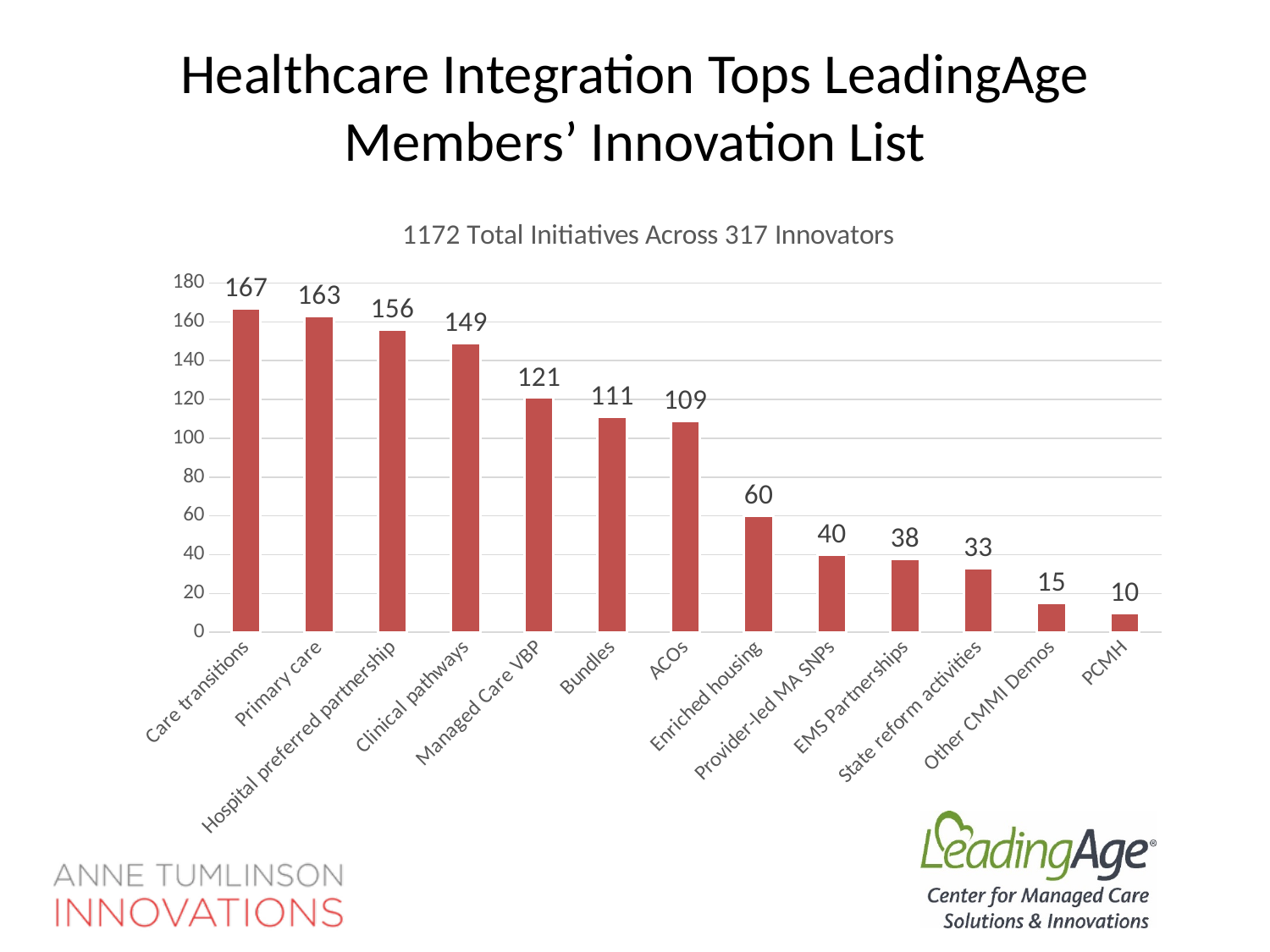
How many categories are shown on the chart? 13 What is the title of the chart? 1172 Total Initiatives Across 317 Innovators What is the value for Enriched housing? 60 Which category has the highest value? Care transitions What is the difference between the values for Primary care and Clinical pathways? 14 What is the value for Managed Care VBP? 121 Which is larger, the value for Bundles or the value for ACOs? Bundles Do the values rise or fall from left to right along the x axis? fall Is the value for Hospital preferred partnership greater or less than 140? greater What is the value for Care transitions? 167 What kind of chart is shown on the slide? bar chart Which category has the lowest value? PCMH